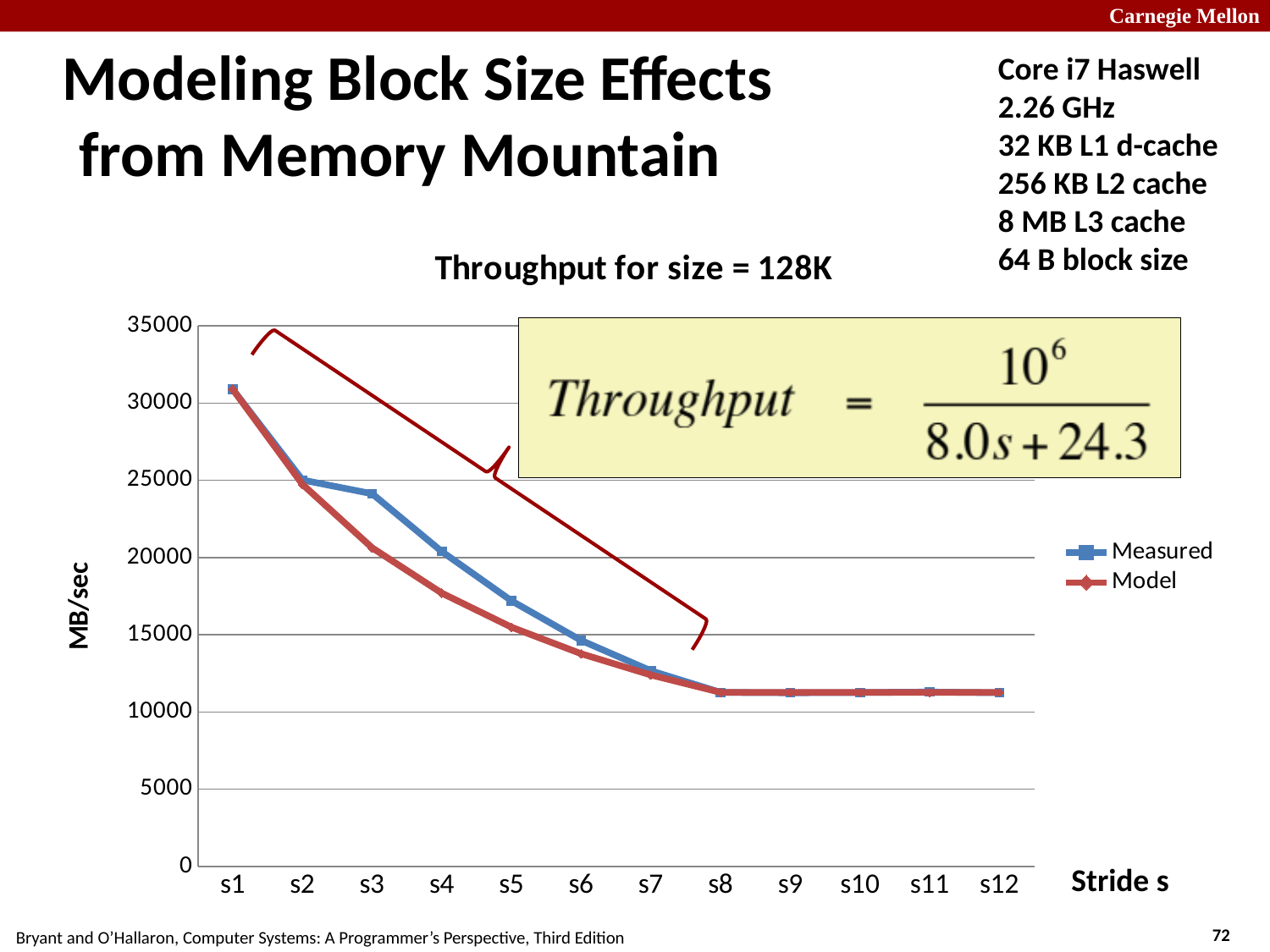
Is the Measured value at s2 greater or less than 20000? greater At stride s4, which series has the larger value, Measured or Model? Measured How many series does the legend list? 2 How many stride values are plotted along the x axis? 12 Do the Measured values rise or fall as the stride increases from s1 to s8? fall Is the Measured value at s8 greater or less than 15000? less What is the title of the chart? Throughput for size = 128K What kind of chart is shown on the slide? line chart At stride s3, which series has the larger value, Measured or Model? Measured At which stride is the Measured throughput highest? s1 Is the Measured value at s1 greater or less than 25000? greater